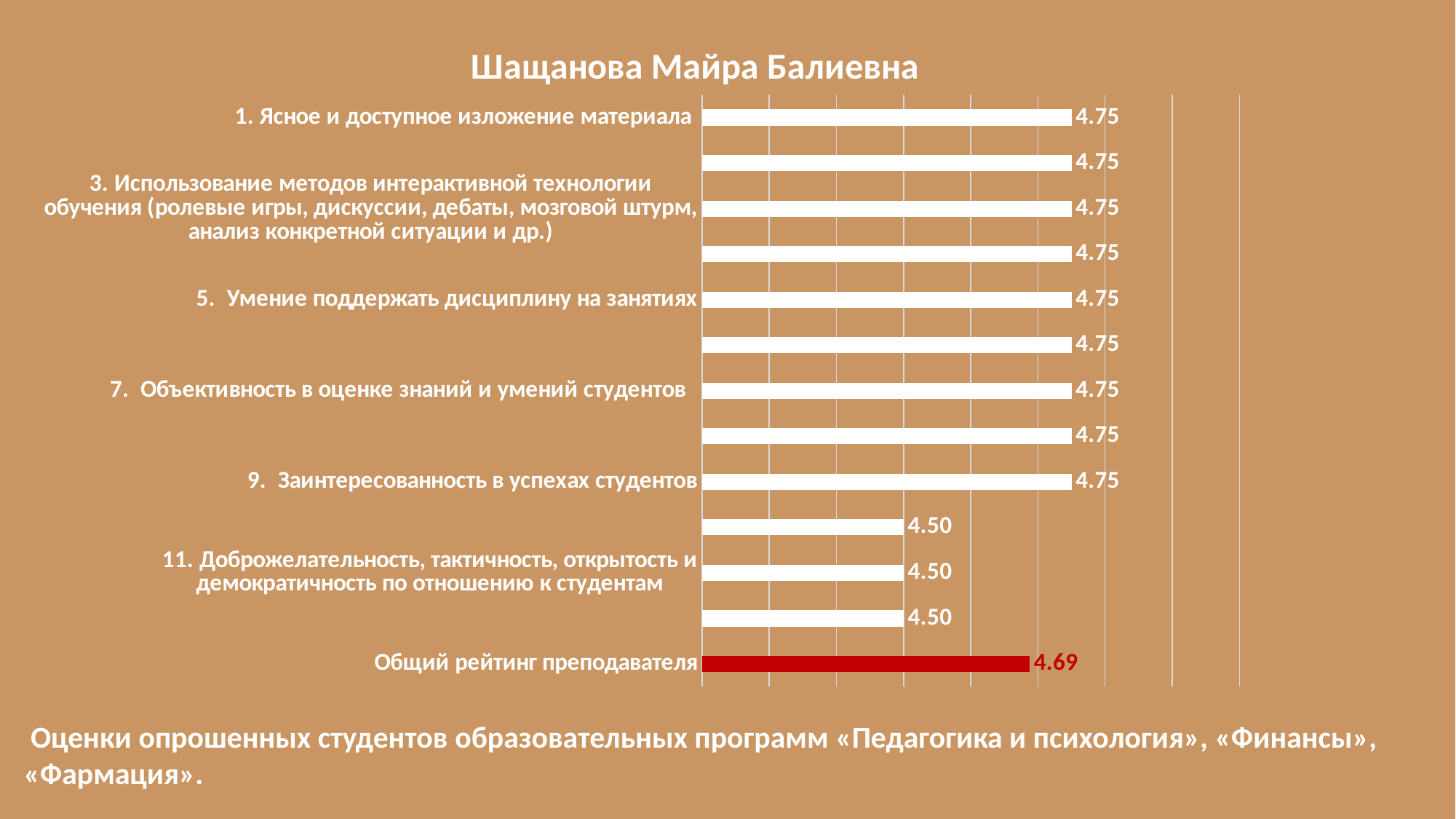
What is the difference between the value for criterion 1 (Ясное и доступное изложение материала) and the "Общий рейтинг преподавателя"? 0.06 What is the value for "9. Заинтересованность в успехах студентов"? 4.75 What is the value for "5. Умение поддержать дисциплину на занятиях"? 4.75 What is the highest value shown on the chart? 4.75 What is the title of the chart? Шащанова Майра Балиевна What is the value for "11. Доброжелательность, тактичность, открытость и демократичность по отношению к студентам"? 4.50 What is the value for "1. Ясное и доступное изложение материала"? 4.75 Which has the larger value: "7. Объективность в оценке знаний и умений студентов" or "11. Доброжелательность, тактичность, открытость и демократичность по отношению к студентам"? 7. Объективность в оценке знаний и умений студентов What is the value of the "Общий рейтинг преподавателя" bar? 4.69 What is the difference between the value for criterion 1 (Ясное и доступное изложение материала) and criterion 11 (Доброжелательность, тактичность...)? 0.25 What kind of chart is shown on the slide? Bar chart What is the lowest value shown on the chart? 4.50